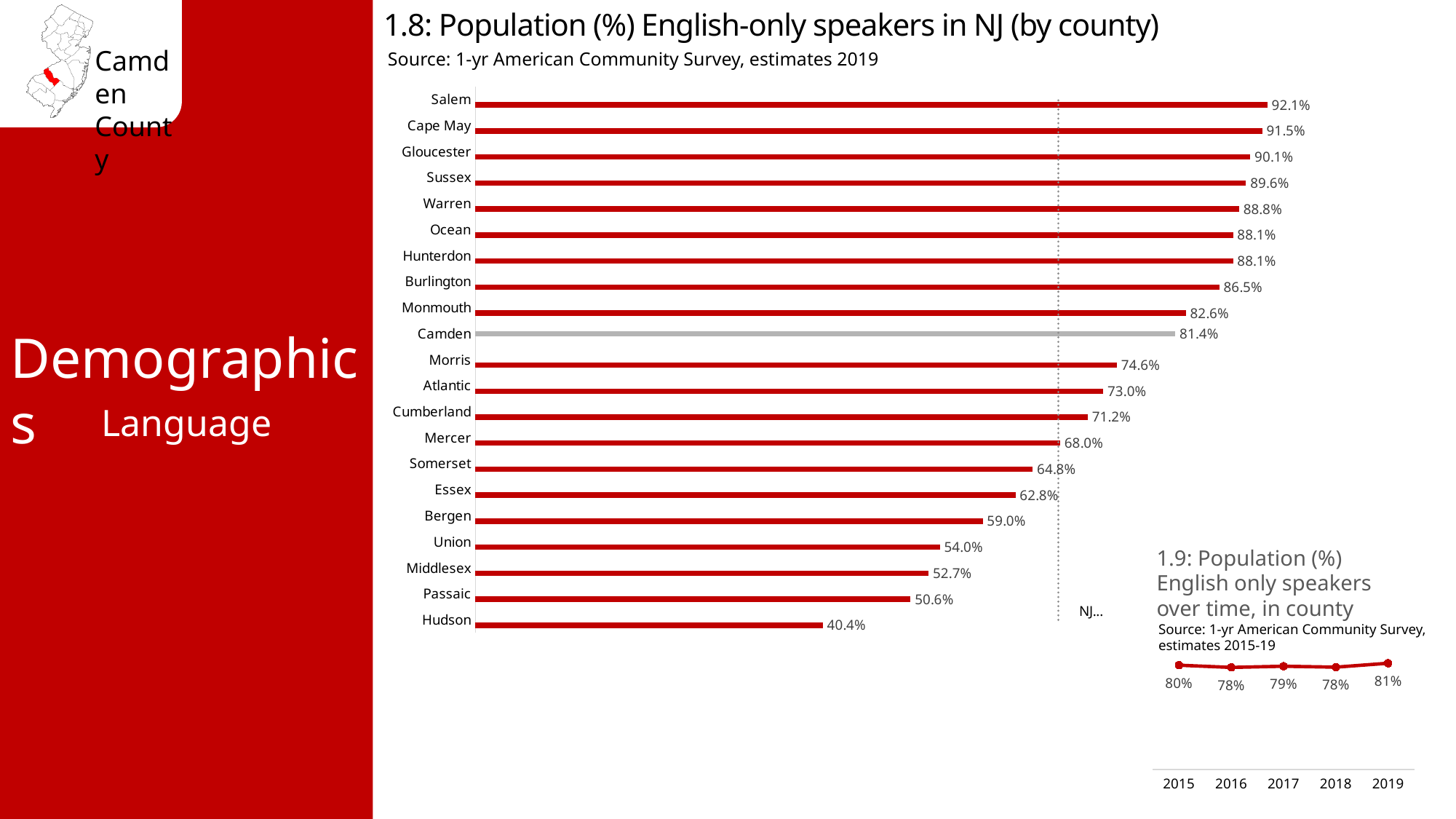
In chart 1.8 (Population (%) English-only speakers in NJ by county), what is the value for Camden? 81.4% In chart 1.9, how many years are plotted? 5 In chart 1.8, what is the value for Hudson? 40.4% In chart 1.8, what is the difference between the values for Salem and Hudson? 51.7% What kind of chart is chart 1.8? Bar chart In chart 1.9 (Population (%) English only speakers over time, in county), what is the value for 2019? 81% In chart 1.8, which county has a larger value, Morris or Bergen? Morris In chart 1.8, which county has the lowest percentage of English-only speakers? Hudson In chart 1.8, which county's bar is shown in grey rather than red? Camden In chart 1.8, what is the value for Gloucester? 90.1% In chart 1.8, how many counties are plotted? 21 In chart 1.8, which county has the highest percentage of English-only speakers? Salem